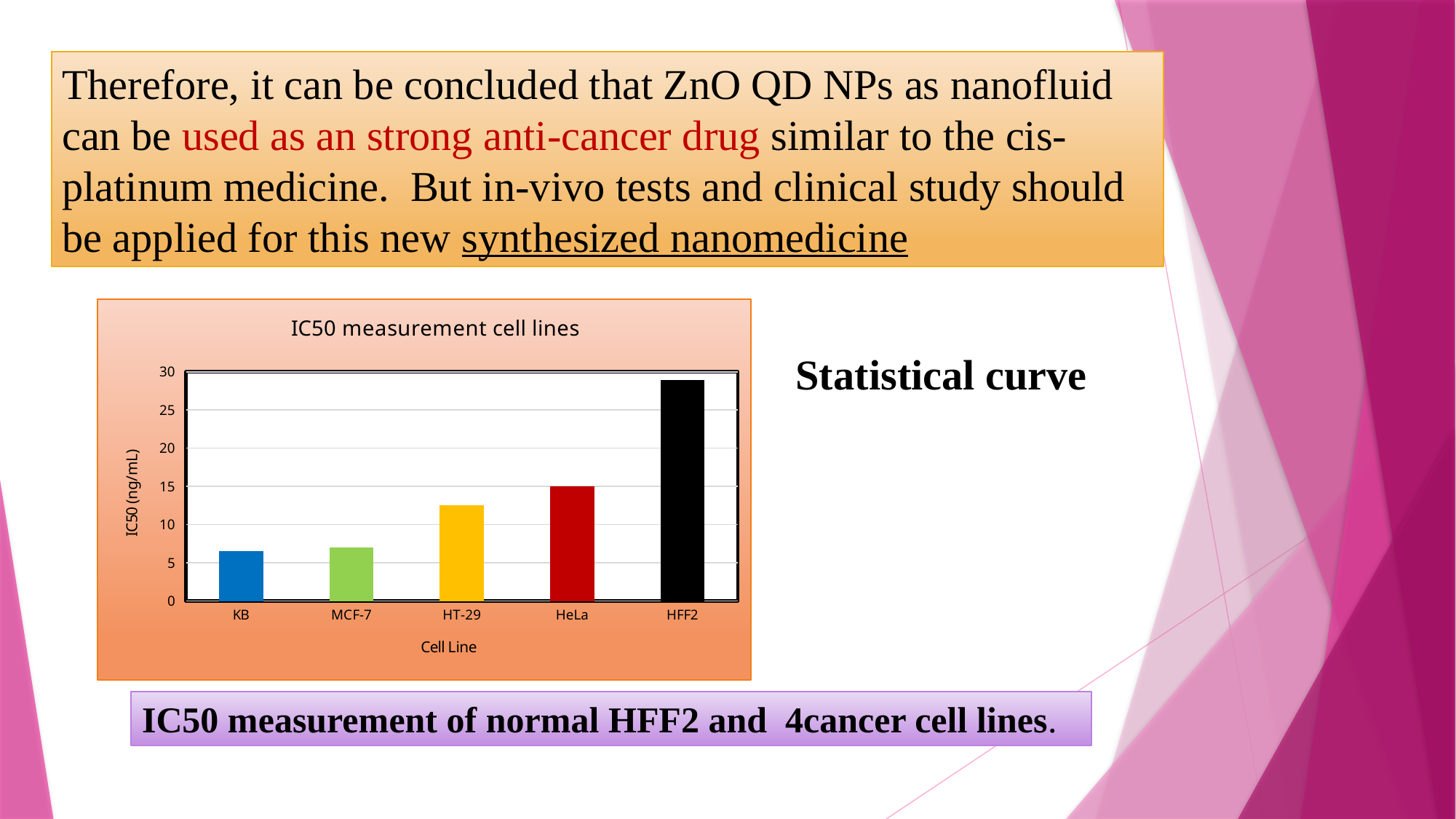
Which has a higher IC50 value, HeLa or HT-29? HeLa Is the IC50 value for HT-29 greater or less than 10? greater Is the IC50 value for HFF2 greater or less than 25? greater Do the IC50 values rise or fall moving from KB to HFF2 along the x axis? rise What kind of chart is shown on the slide? bar chart Which cell line has the highest IC50 value in the chart? HFF2 How many cell lines are plotted on the x axis of the chart? 5 Which has a higher IC50 value, HFF2 or HeLa? HFF2 What is the label of the y axis of the chart? IC50 (ng/mL) Is the IC50 value for KB greater or less than 10? less What is the title of the chart? IC50 measurement cell lines